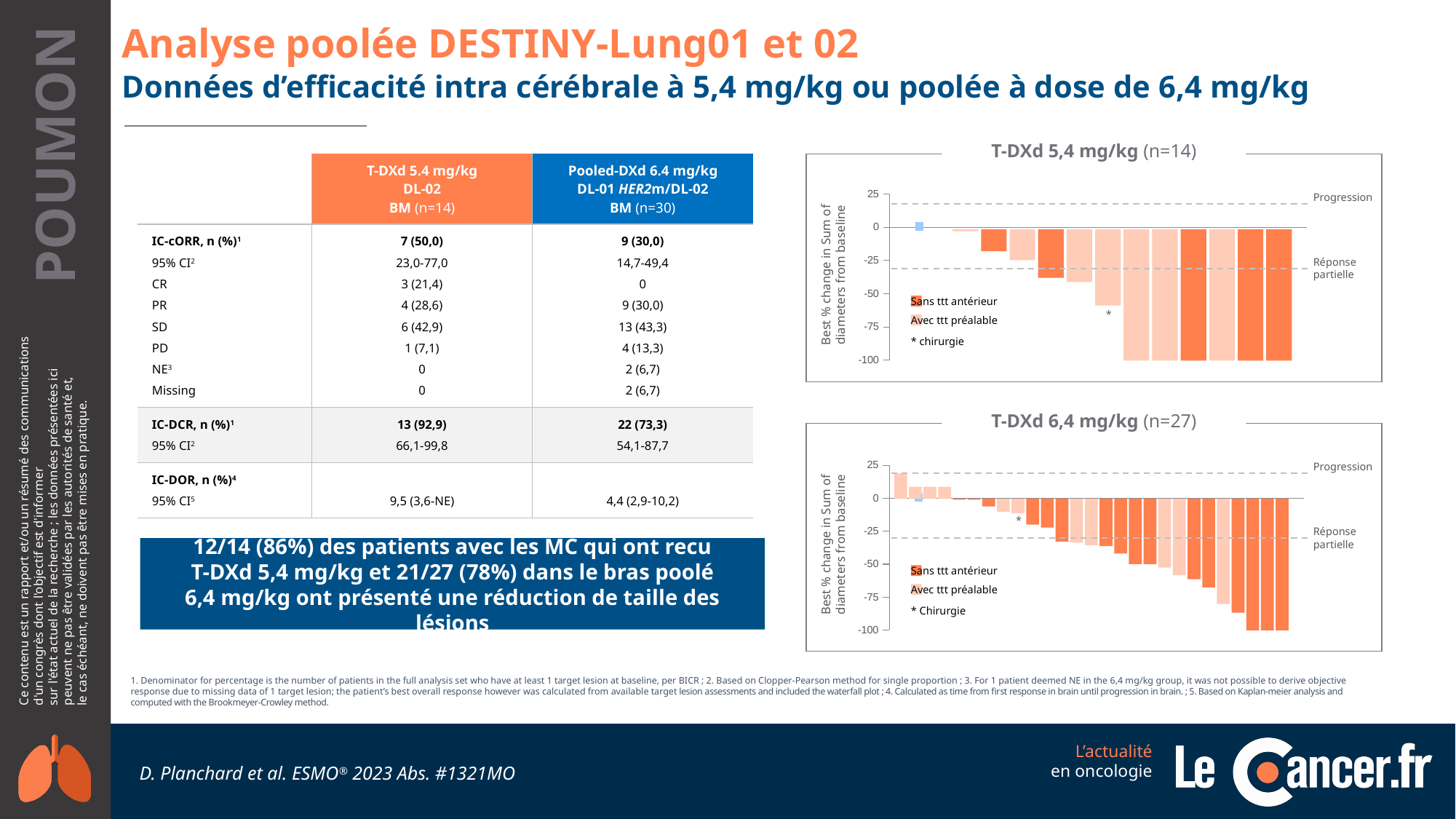
Which of the two charts contains more bars, the top one (5,4 mg/kg) or the bottom one (6,4 mg/kg)? the bottom one (6,4 mg/kg) What is the y-axis label of the two waterfall charts? Best % change in Sum of diameters from baseline In the bottom chart (T-DXd 6,4 mg/kg), is the value of the leftmost bar greater or less than 25? less What are the labels of the two dashed horizontal reference lines in the charts? Progression and Réponse partielle In the bottom chart (T-DXd 6,4 mg/kg), is the value of the leftmost bar greater or less than 0? greater In the bottom chart (T-DXd 6,4 mg/kg), what value do the lowest bars reach on the y axis? -100 What type of chart is the top chart titled "T-DXd 5,4 mg/kg (n=14)"? bar chart In the top chart (T-DXd 5,4 mg/kg), do the bar values rise or fall from left to right? fall In the bottom chart (T-DXd 6,4 mg/kg), which is larger: the leftmost bar or the rightmost bar? the leftmost bar In the top chart (T-DXd 5,4 mg/kg), is the value of the bar marked with an asterisk greater or less than -25? less In the top chart (T-DXd 5,4 mg/kg), what value do the lowest bars reach on the y axis? -100 How many treatment categories does the legend of the top chart distinguish by colour? 2